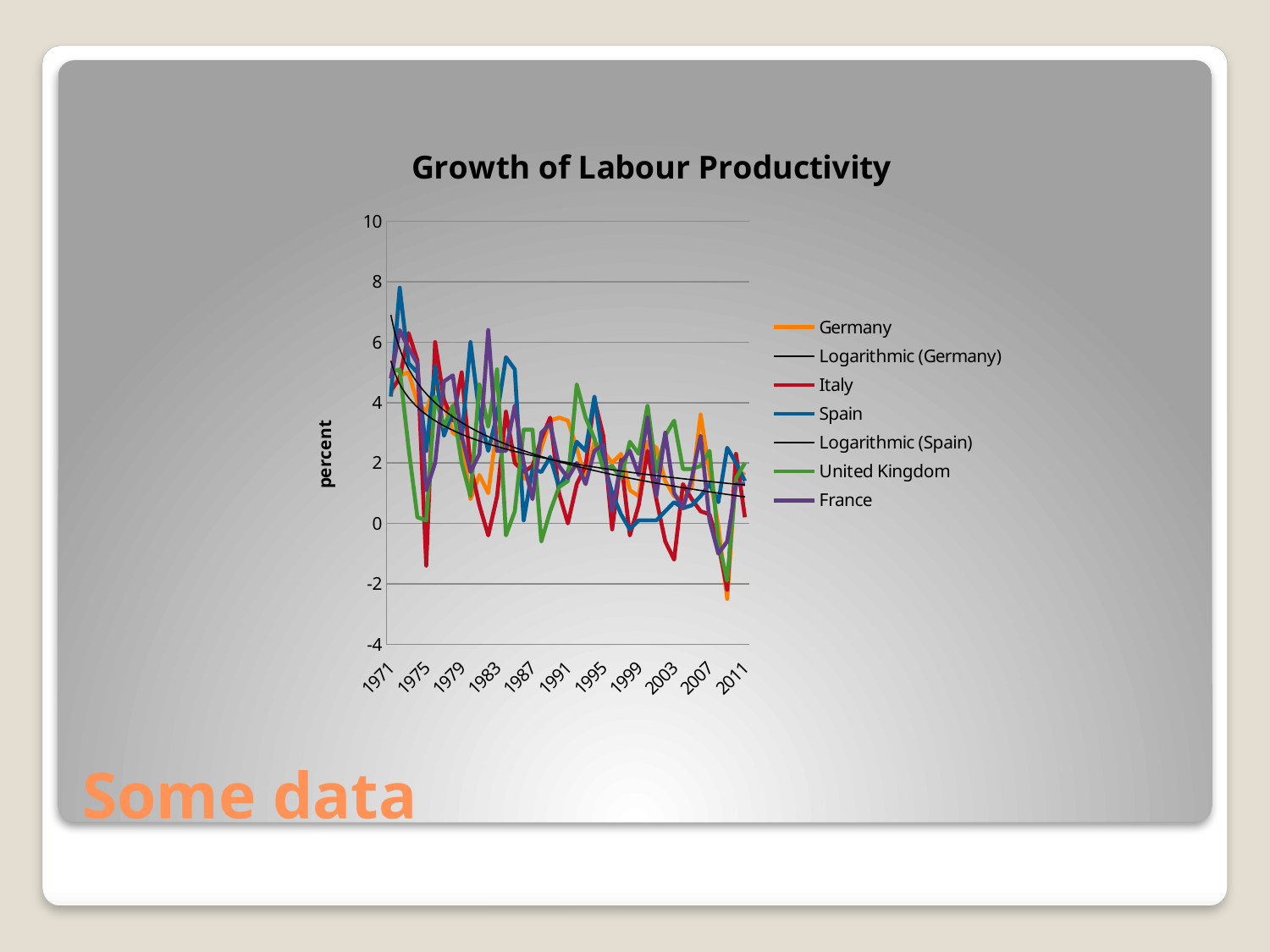
What is the lowest value shown on the vertical axis? -4 What is the label on the vertical axis? percent What is the last year labelled on the horizontal axis? 2011 How many series does the legend list? 7 Is the value for Italy at its dip around 1975 greater or less than 0? less Do the logarithmic trend lines rise or fall from 1971 to 2011? fall What kind of chart is shown on the slide? line chart Is the lowest value for Germany around 2009 greater or less than 0? less Is the highest value for Spain in the early 1970s greater or less than 6? greater